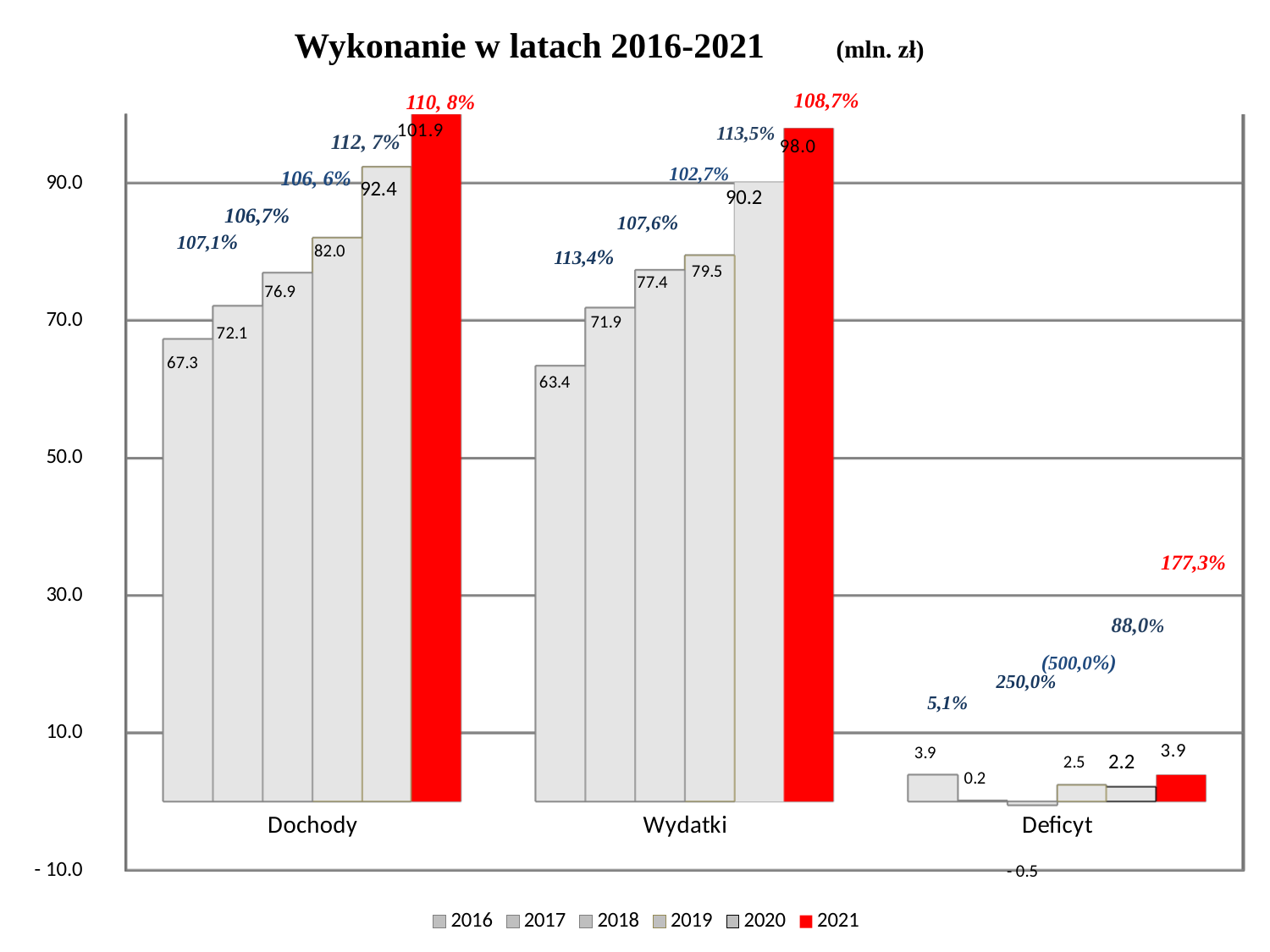
Do the Wydatki values rise or fall from 2016 to 2021? rise What is the difference between Dochody and Wydatki in 2021? 3.9 How many categories are shown on the x axis? 3 What is the value for Wydatki in 2020? 90.2 How many series does the legend list? 6 Which year has the lowest value for Deficyt? 2018 What is the value for Wydatki in 2016? 63.4 Which year has the highest value for Dochody? 2021 What is the value for Deficyt in 2019? 2.5 Which is larger, Dochody in 2019 or Wydatki in 2019? Dochody in 2019 What is the value for Dochody in 2021? 101.9 What kind of chart is shown on the slide? bar chart